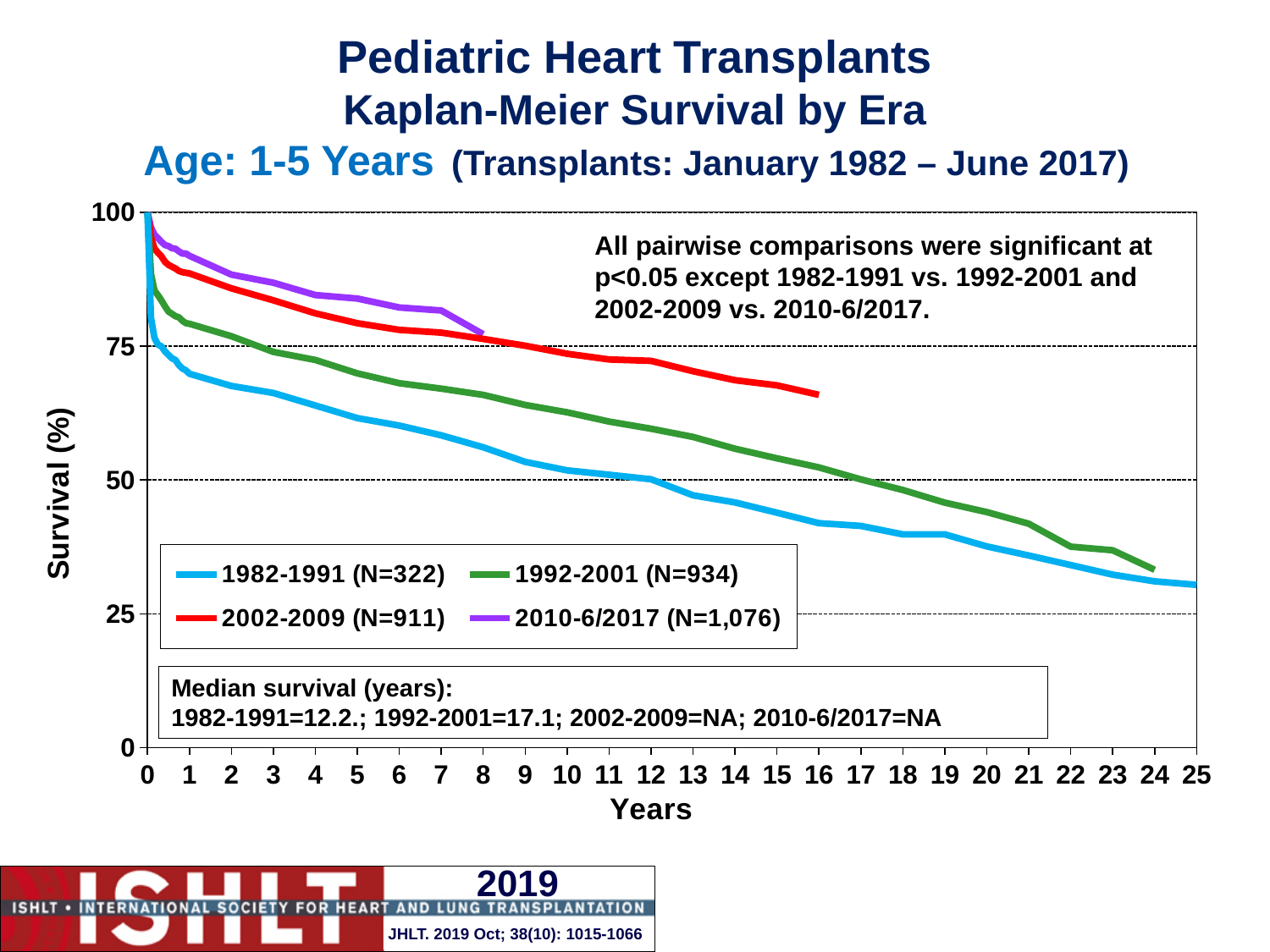
At 15 years, which era has lower survival: 1992-2001 or 2002-2009? 1992-2001 How many series does the legend list? 4 Is the survival value for the 2002-2009 era at 5 years greater or less than 75? greater Is the survival value for the 1992-2001 era at 20 years greater or less than 50? less What kind of chart is shown on the slide? Line chart Which era has the lowest survival curve across the chart? 1982-1991 At 10 years, which era has higher survival: 2002-2009 or 1982-1991? 2002-2009 According to the legend, what is the N for the 2010-6/2017 era? N=1,076 Does survival for the 1982-1991 era rise or fall as years increase? Fall Is the survival value for the 2010-6/2017 era at 5 years greater or less than 75? greater